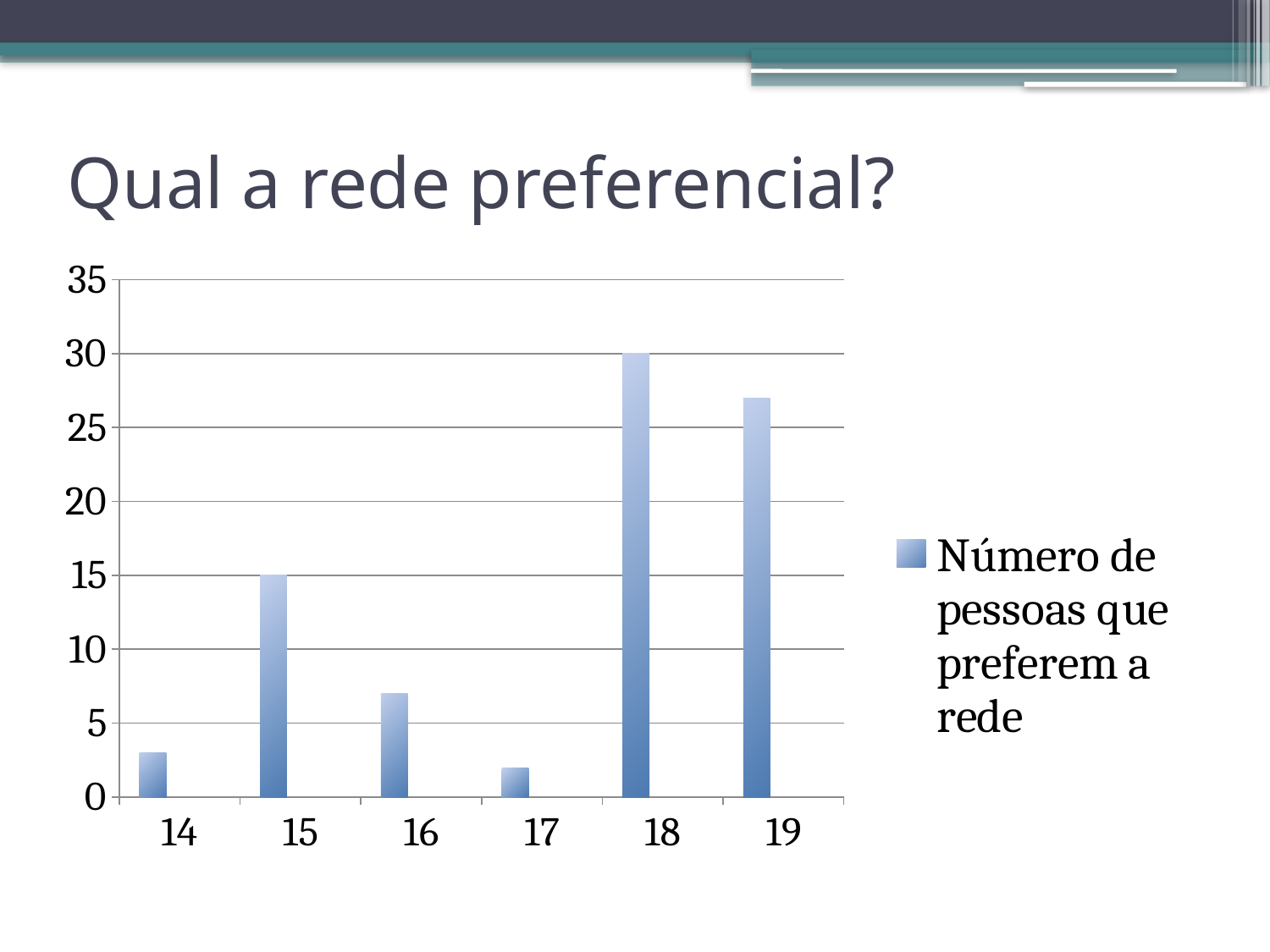
How many series does the legend list? 1 Is the value for category 14 greater or less than 5? less What is the value for category 18? 30 What is the difference between the values for categories 18 and 15? 15 What kind of chart is shown on the slide? bar chart Which category has the highest value? 18 Which has a larger value, category 15 or category 16? 15 Is the value for category 19 greater or less than 25? greater How many categories are shown on the x axis? 6 What is the value for category 15? 15 Is the value for category 16 greater or less than 10? less Which has a larger value, category 18 or category 19? 18